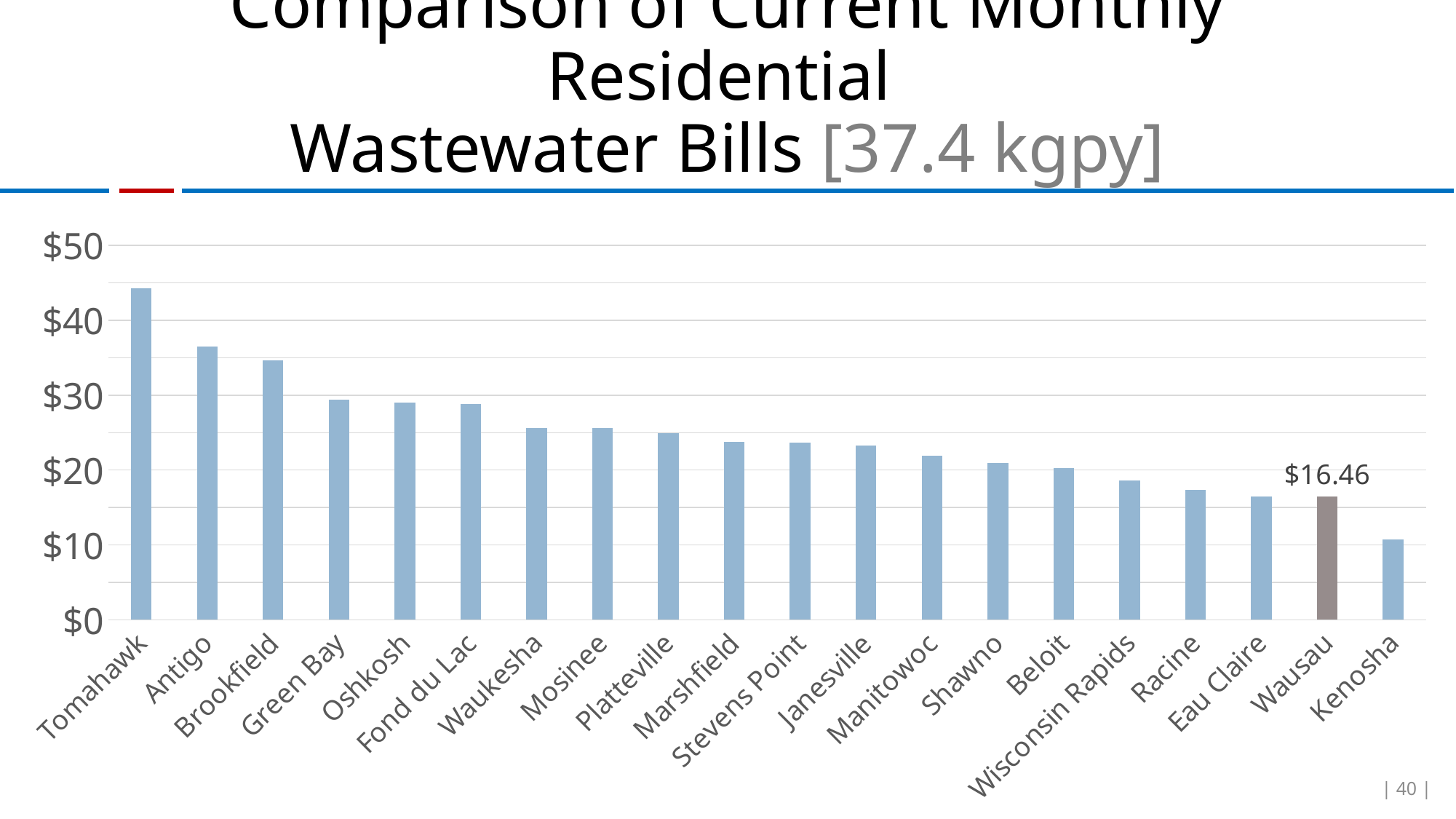
Which has the larger monthly bill, Brookfield or Green Bay? Brookfield What kind of chart is shown on the slide? Bar chart Which has the larger monthly bill, Tomahawk or Antigo? Tomahawk Which city's bar is shown in a different colour from the rest? Wausau What is the monthly residential wastewater bill shown for Wausau? $16.46 Is the value for Tomahawk greater or less than $40? greater Do the bill values rise or fall moving from left to right across the chart? Fall Which city has the highest monthly residential wastewater bill? Tomahawk How many cities are shown on the chart? 20 Is the value for Brookfield greater or less than $30? greater Which city has the lowest monthly residential wastewater bill? Kenosha Is the value for Wisconsin Rapids greater or less than $20? less